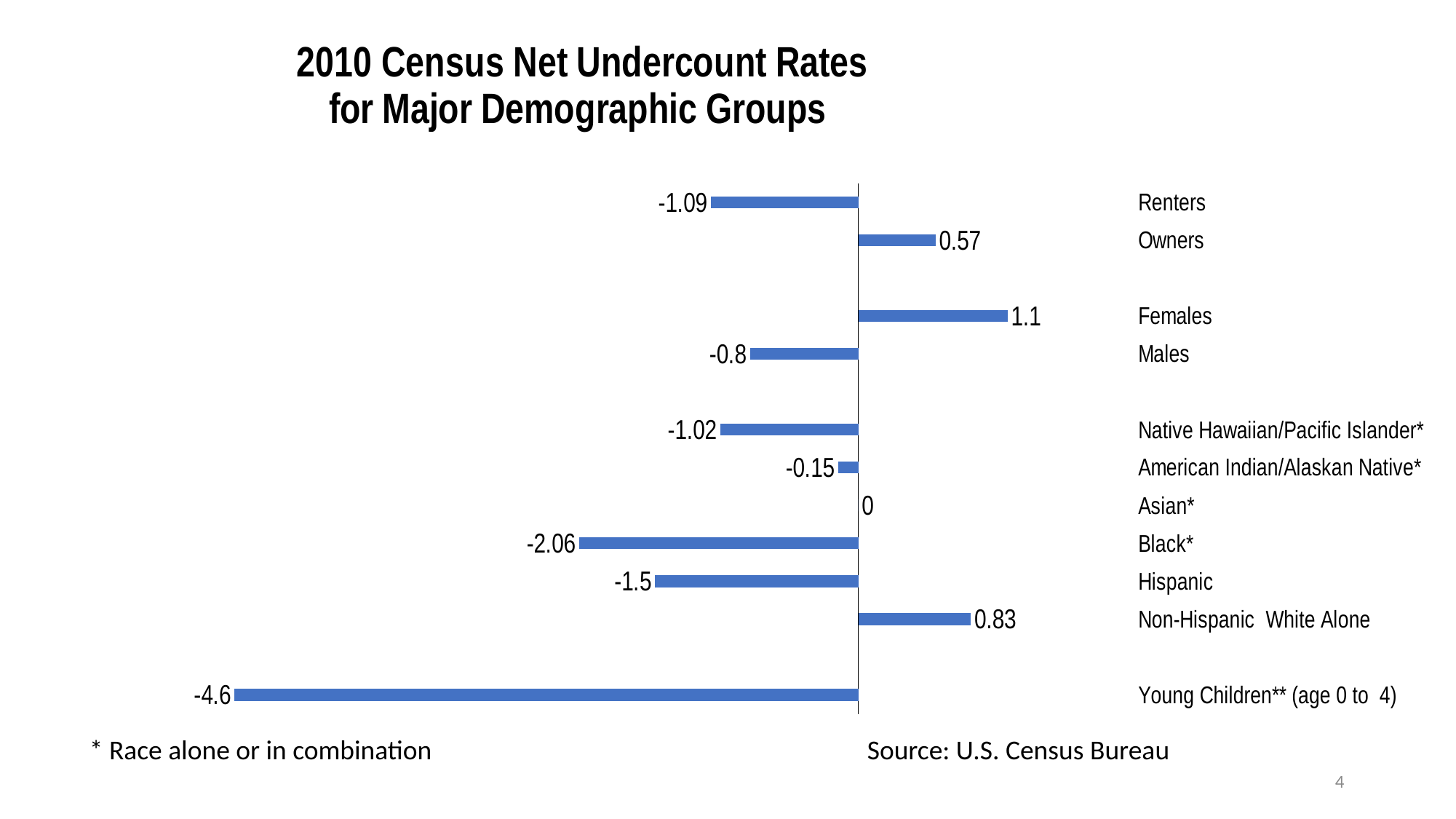
Which has a higher net undercount rate, Hispanic or Males? Males Which group has the highest net undercount rate? Females What is the difference between the rates for Owners and Non-Hispanic White Alone? 0.26 What is the net undercount rate for Females? 1.1 What is the net undercount rate for Asian*? 0 What is the net undercount rate for Renters? -1.09 What is the title of the chart? 2010 Census Net Undercount Rates for Major Demographic Groups Which group has the lowest (most negative) net undercount rate? Young Children** (age 0 to 4) What is the net undercount rate for Young Children** (age 0 to 4)? -4.6 What type of chart is shown on the slide? Bar chart What is the net undercount rate for Black*? -2.06 How many demographic groups are plotted in the chart? 11